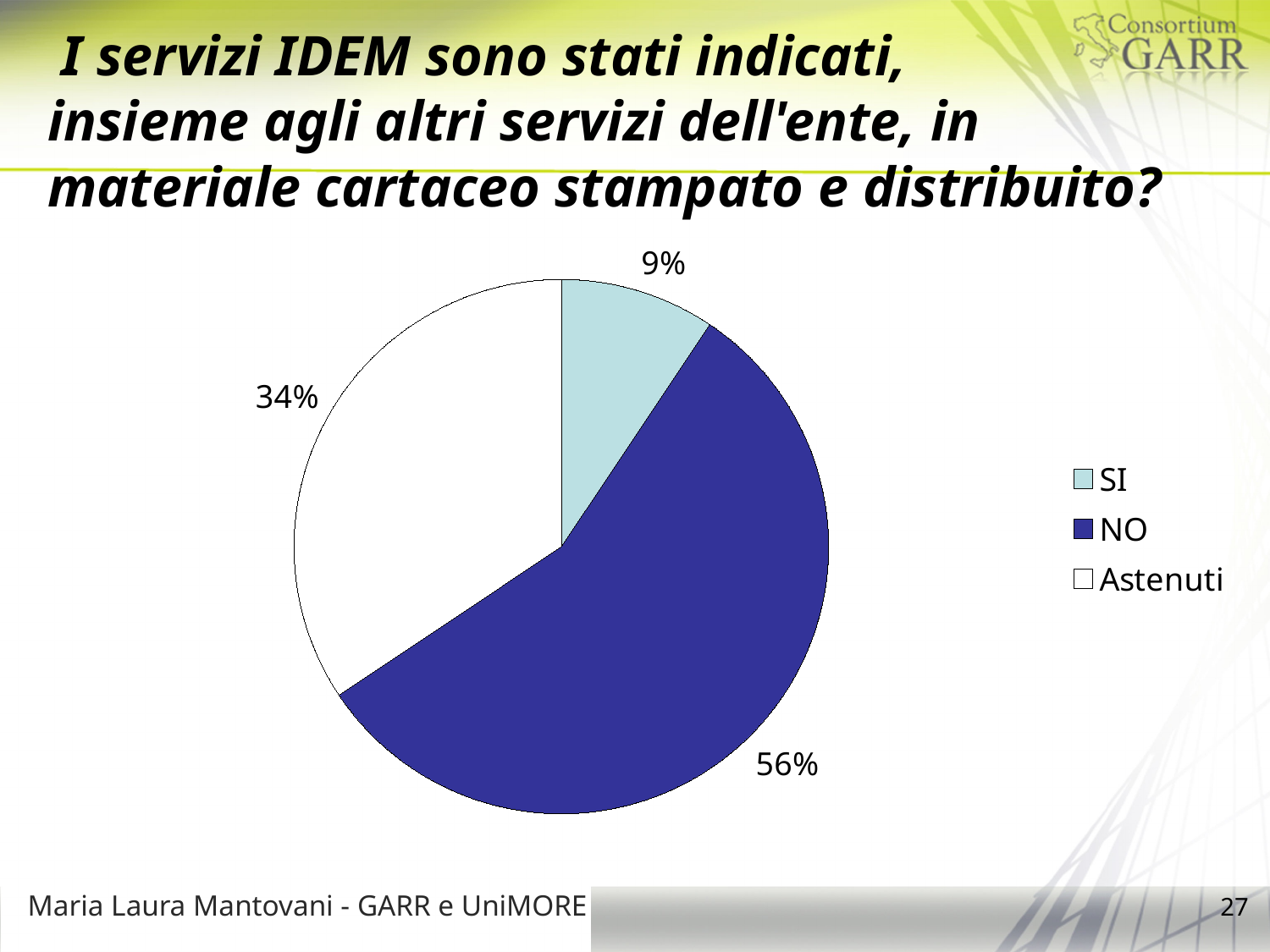
Which category has the largest slice of the pie? NO Which category has the smallest slice of the pie? SI What is the difference in percentage points between the Astenuti slice and the SI slice? 25 What share of the pie does the Astenuti slice represent? 34% How many entries does the legend list? 3 What kind of chart is shown on the slide? pie chart What share of the pie does the NO slice represent? 56% How many slices does the pie chart have? 3 What share of the pie does the SI slice represent? 9% What colour is the NO slice in the pie chart? dark blue Which is larger, the Astenuti slice or the SI slice? Astenuti What is the difference in percentage points between the NO slice and the Astenuti slice? 22